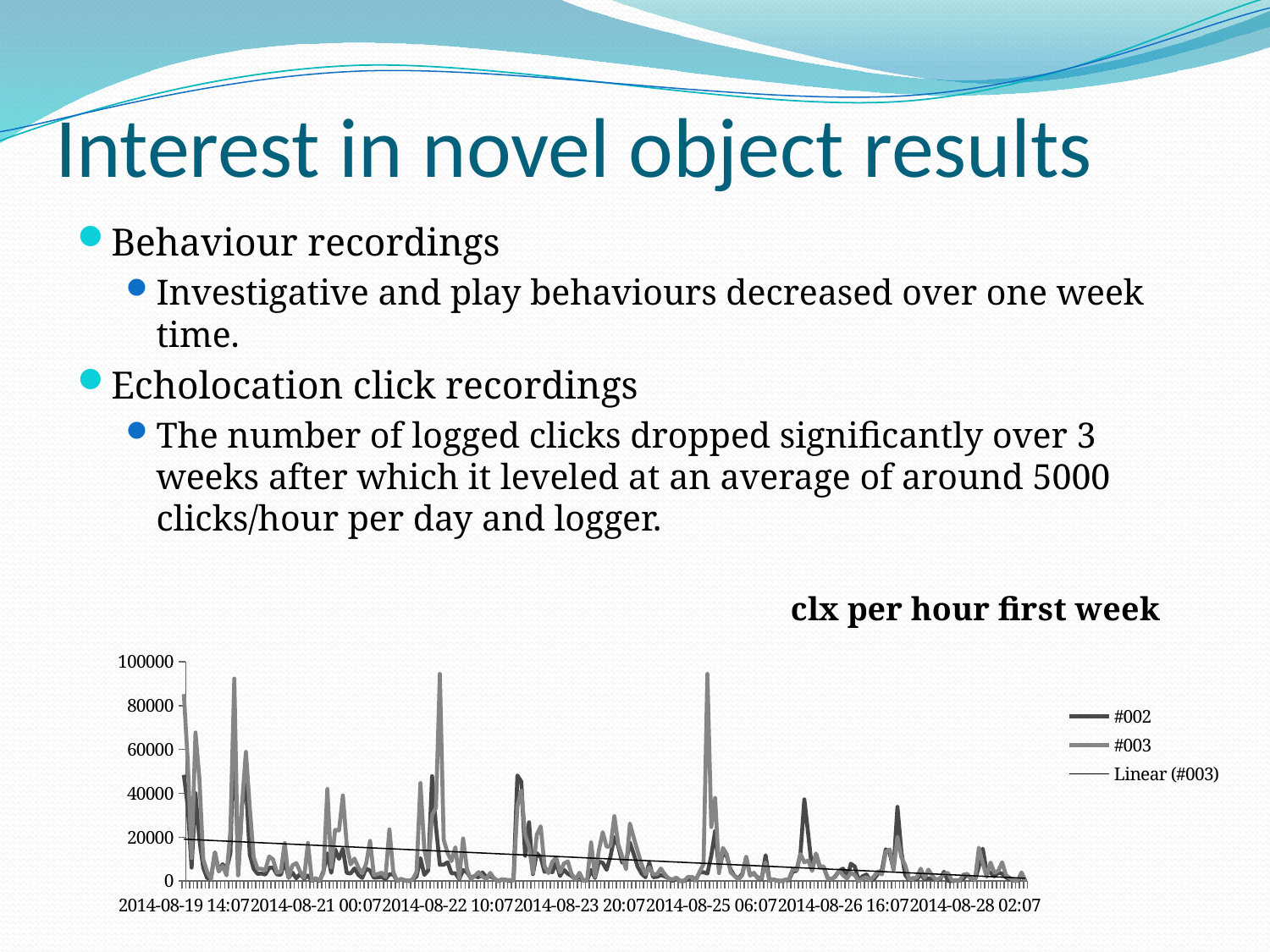
What is the title of the chart? clx per hour first week What is the last date label shown on the chart's x axis? 2014-08-28 02:07 Is the value of the linear trendline at the left edge of the chart greater or less than 40000? less Which series does the linear trendline in the chart belong to? #003 What kind of chart is shown on the slide? line chart How many entries does the chart legend list? 3 Is the highest peak of series #003 greater or less than 80000? greater Does the linear trendline for #003 rise or fall from left to right along the x axis? fall Overall, do the click counts in the chart rise or fall over the week? fall